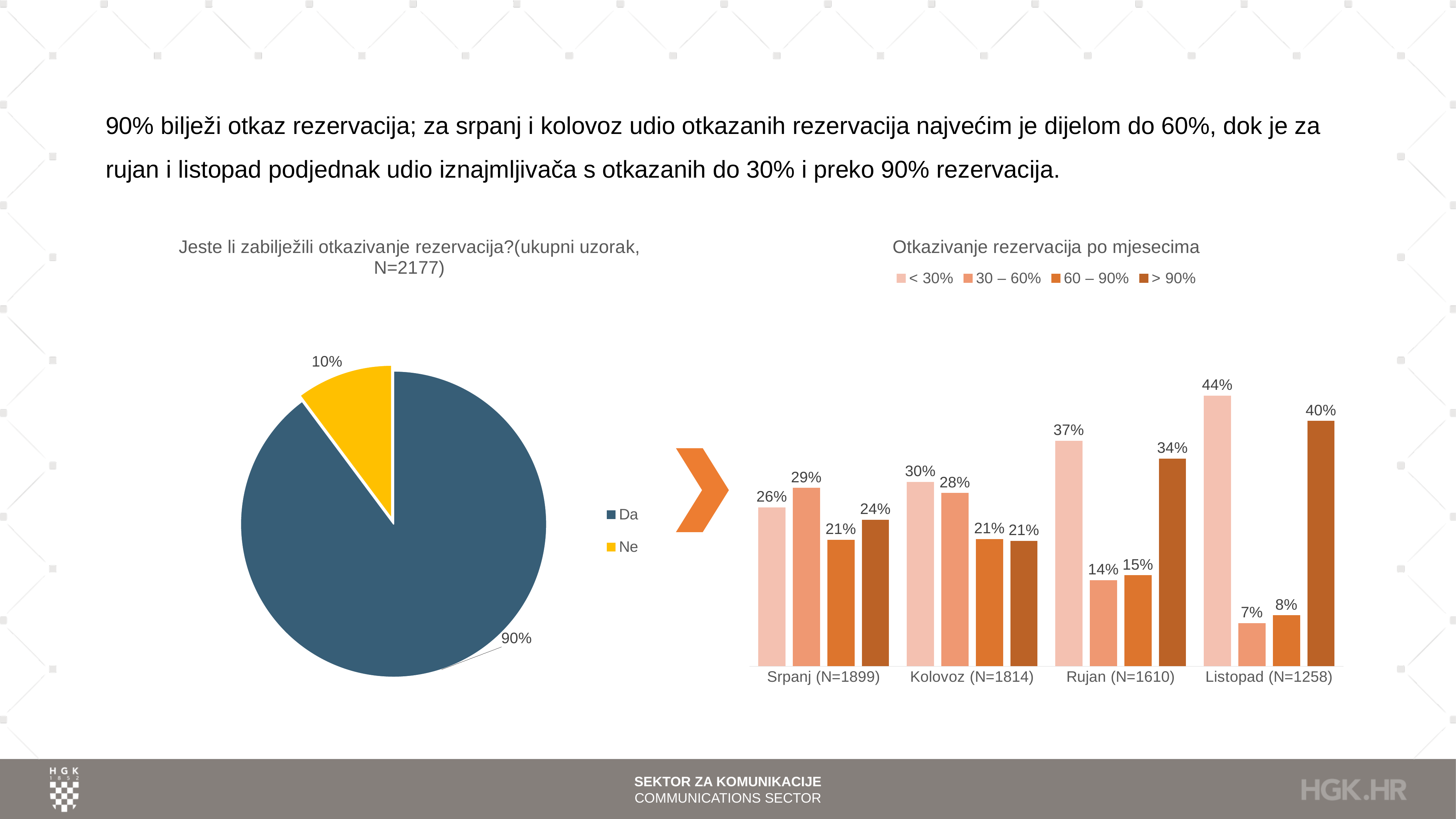
In the chart 'Otkazivanje rezervacija po mjesecima', how many series does the legend list? 4 In the chart 'Otkazivanje rezervacija po mjesecima', which month has the lowest value for the '30 – 60%' series? Listopad (N=1258) In the chart 'Otkazivanje rezervacija po mjesecima', what is the difference between the '> 90%' value for Listopad (N=1258) and the '> 90%' value for Srpanj (N=1899)? 16% In the pie chart on the left, what share of respondents answered 'Ne'? 10% In the chart 'Otkazivanje rezervacija po mjesecima', how many month categories are shown on the x axis? 4 What kind of chart is the chart on the right titled 'Otkazivanje rezervacija po mjesecima'? bar chart In the chart 'Otkazivanje rezervacija po mjesecima', which month has the highest value for the '< 30%' series? Listopad (N=1258) In the chart 'Otkazivanje rezervacija po mjesecima', which is larger for Kolovoz (N=1814): the '< 30%' value or the '30 – 60%' value? < 30% In the pie chart on the left, what share of respondents answered 'Da'? 90% What kind of chart is the chart on the left titled 'Jeste li zabilježili otkazivanje rezervacija?'? pie chart In the chart 'Otkazivanje rezervacija po mjesecima', what is the value of the '< 30%' series for Listopad (N=1258)? 44% In the chart 'Otkazivanje rezervacija po mjesecima', what is the value of the '> 90%' series for Rujan (N=1610)? 34%